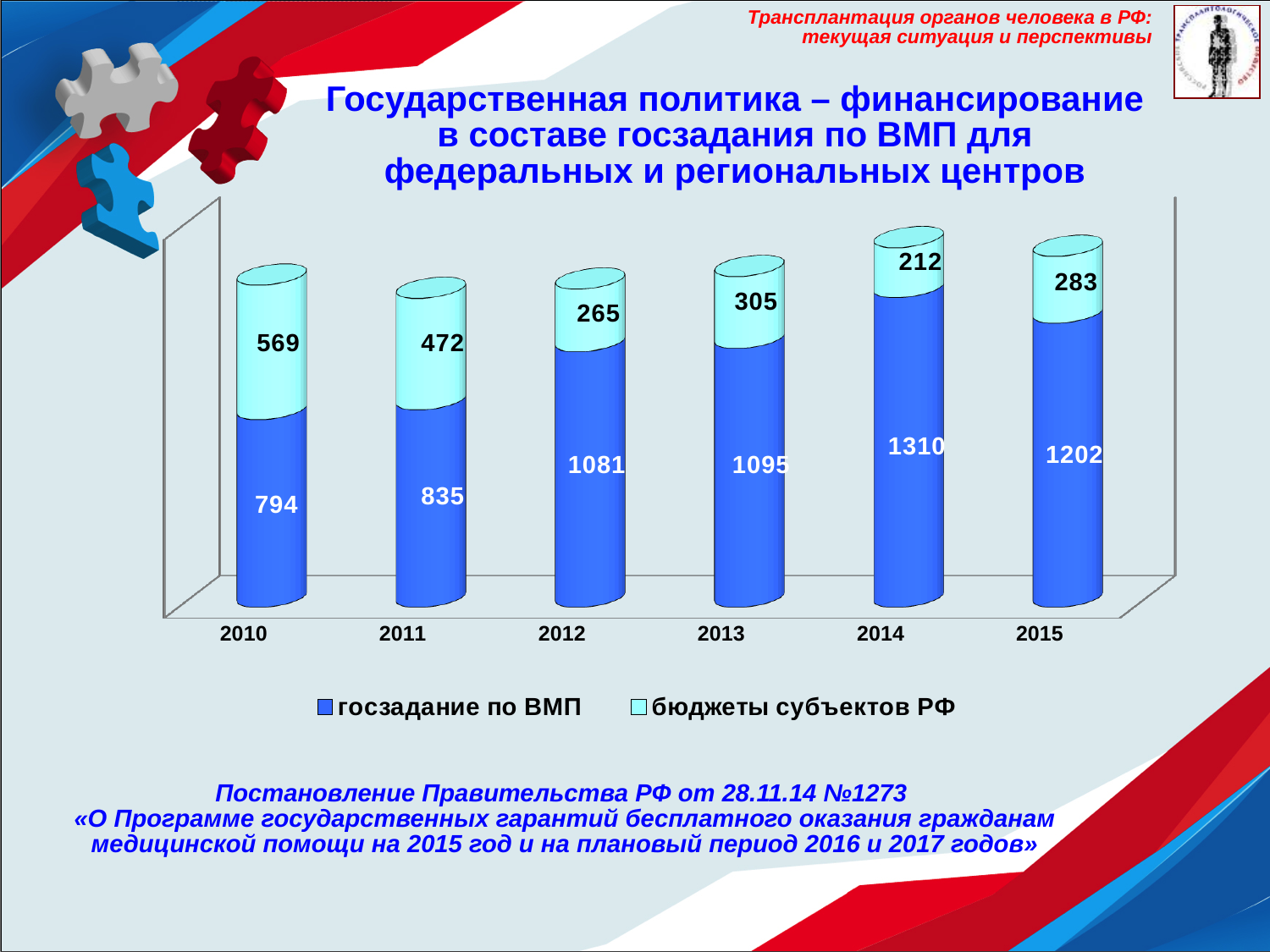
What is the difference between госзадание по ВМП in 2014 and in 2015? 108 What is the total of the stacked bar for 2010? 1363 How many years are shown on the x axis? 6 In which year is бюджеты субъектов РФ lowest? 2014 In which year is госзадание по ВМП highest? 2014 What kind of chart is shown on the slide? Stacked bar chart What is the total of the stacked bar for 2014? 1522 What is the value of госзадание по ВМП for 2012? 1081 How many series does the legend list? 2 What is the value of бюджеты субъектов РФ for 2010? 569 What is the value of госзадание по ВМП for 2014? 1310 Which is larger: бюджеты субъектов РФ in 2013 or in 2012? 2013